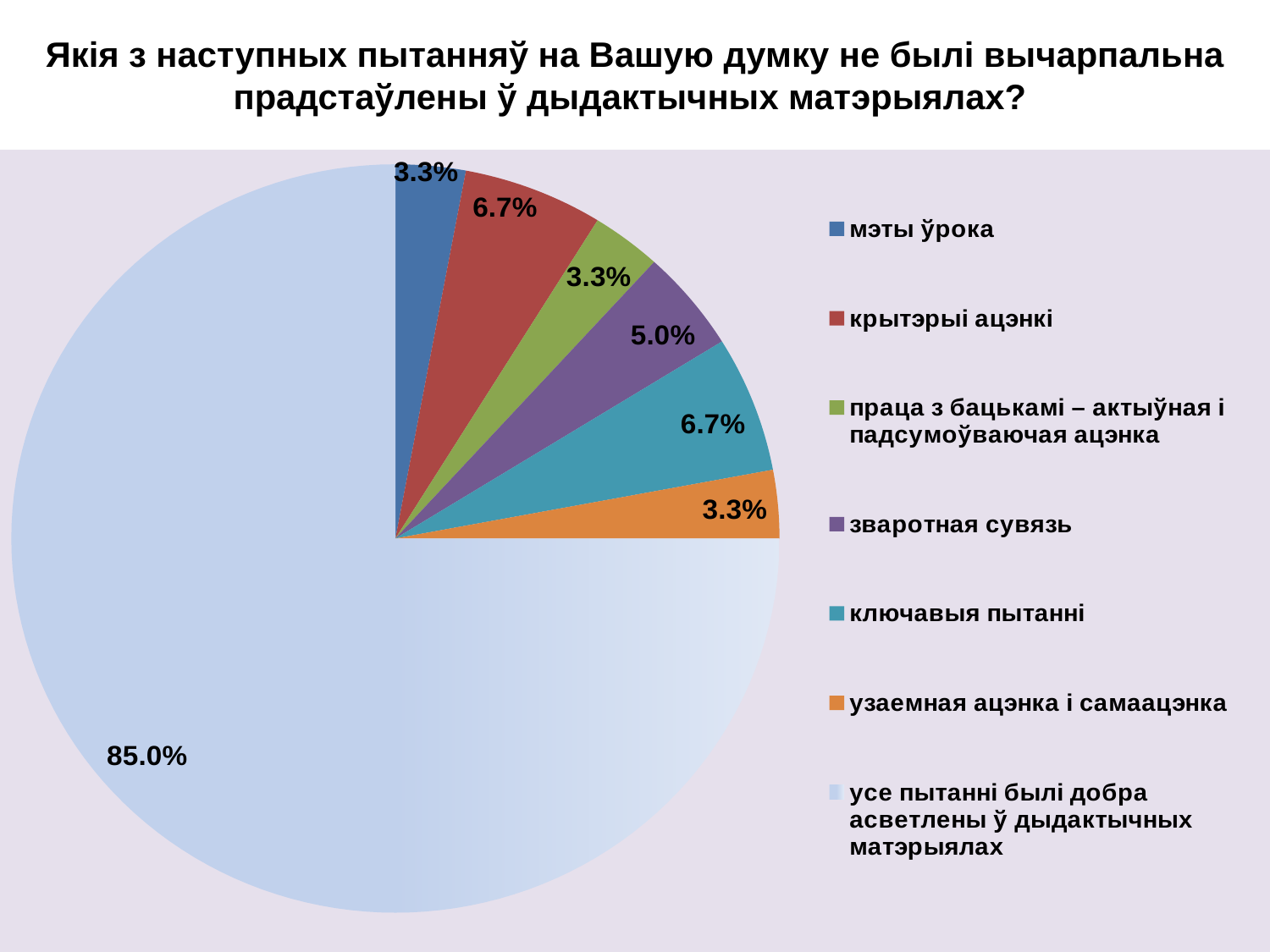
What is the difference between the percentage for "крытэрыі ацэнкі" and the percentage for "зваротная сувязь"? 1.7% What kind of chart is shown on the slide? pie chart What percentage is shown for "мэты ўрока"? 3.3% What percentage is shown for "ключавыя пытанні"? 6.7% What share of the pie is labelled for "усе пытанні былі добра асветлены ў дыдактычных матэрыялах"? 85.0% Which category has the largest slice of the pie? усе пытанні былі добра асветлены ў дыдактычных матэрыялах What colour is the slice for "узаемная ацэнка і самаацэнка"? orange What percentage is shown for "зваротная сувязь"? 5.0% How many slices does the pie chart have? 7 What percentage is shown for "узаемная ацэнка і самаацэнка"? 3.3% What percentage is shown for "крытэрыі ацэнкі"? 6.7% Which is larger, the slice for "зваротная сувязь" or the slice for "мэты ўрока"? зваротная сувязь